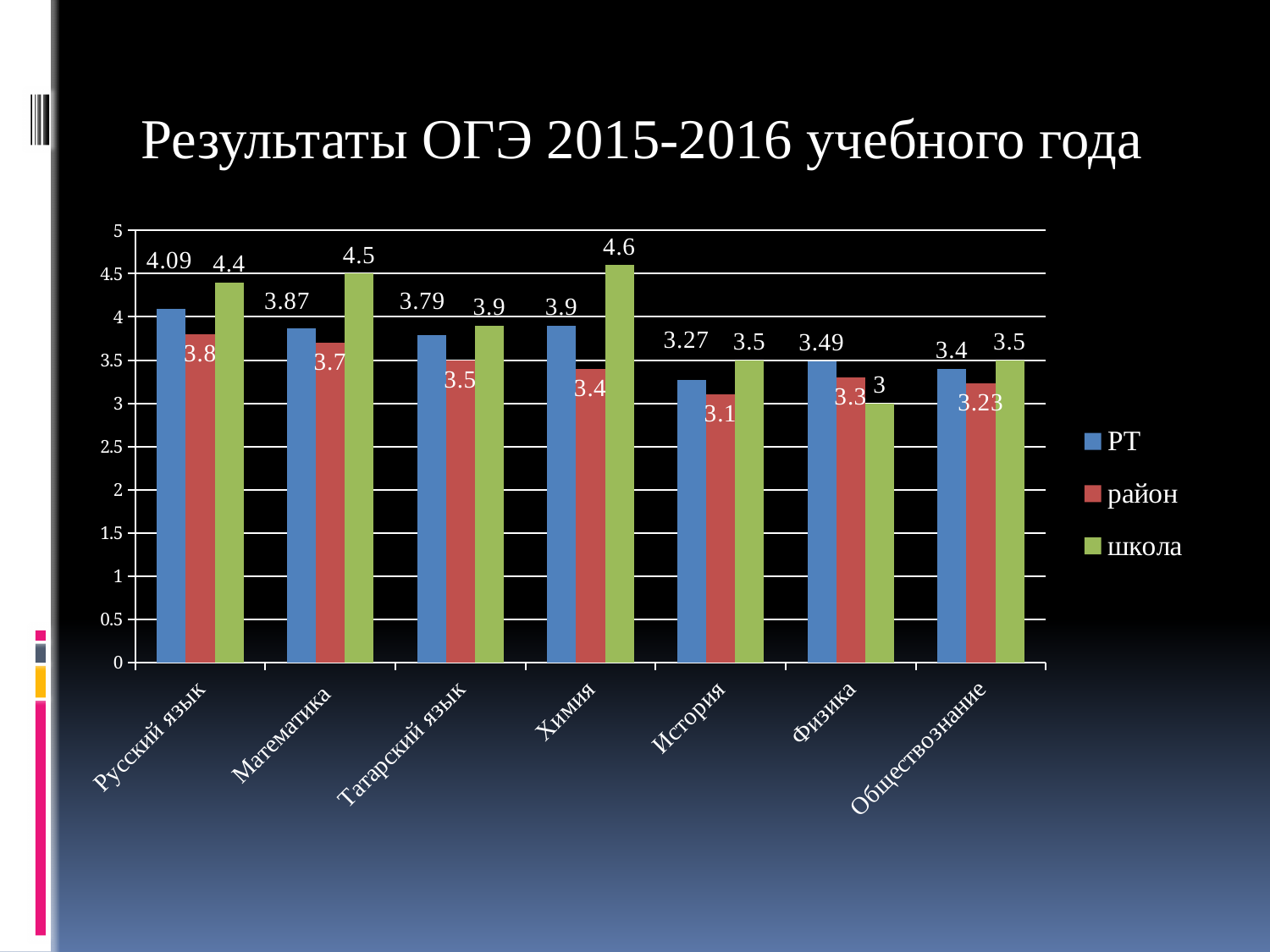
Which is larger for Физика: the РТ value or the школа value? РТ Which subject has the highest value for школа? Химия What is the value for РТ in Русский язык? 4.09 How many series does the legend list? 3 Which subject has the lowest value for РТ? История What is the value for школа in Химия? 4.6 What is the title of the chart? Результаты ОГЭ 2015-2016 учебного года What kind of chart is shown on the slide? bar chart What is the value for район in Обществознание? 3.23 Which colour represents the район series? red How many subjects are shown on the x axis? 7 What is the difference between the школа and РТ values for Математика? 0.63